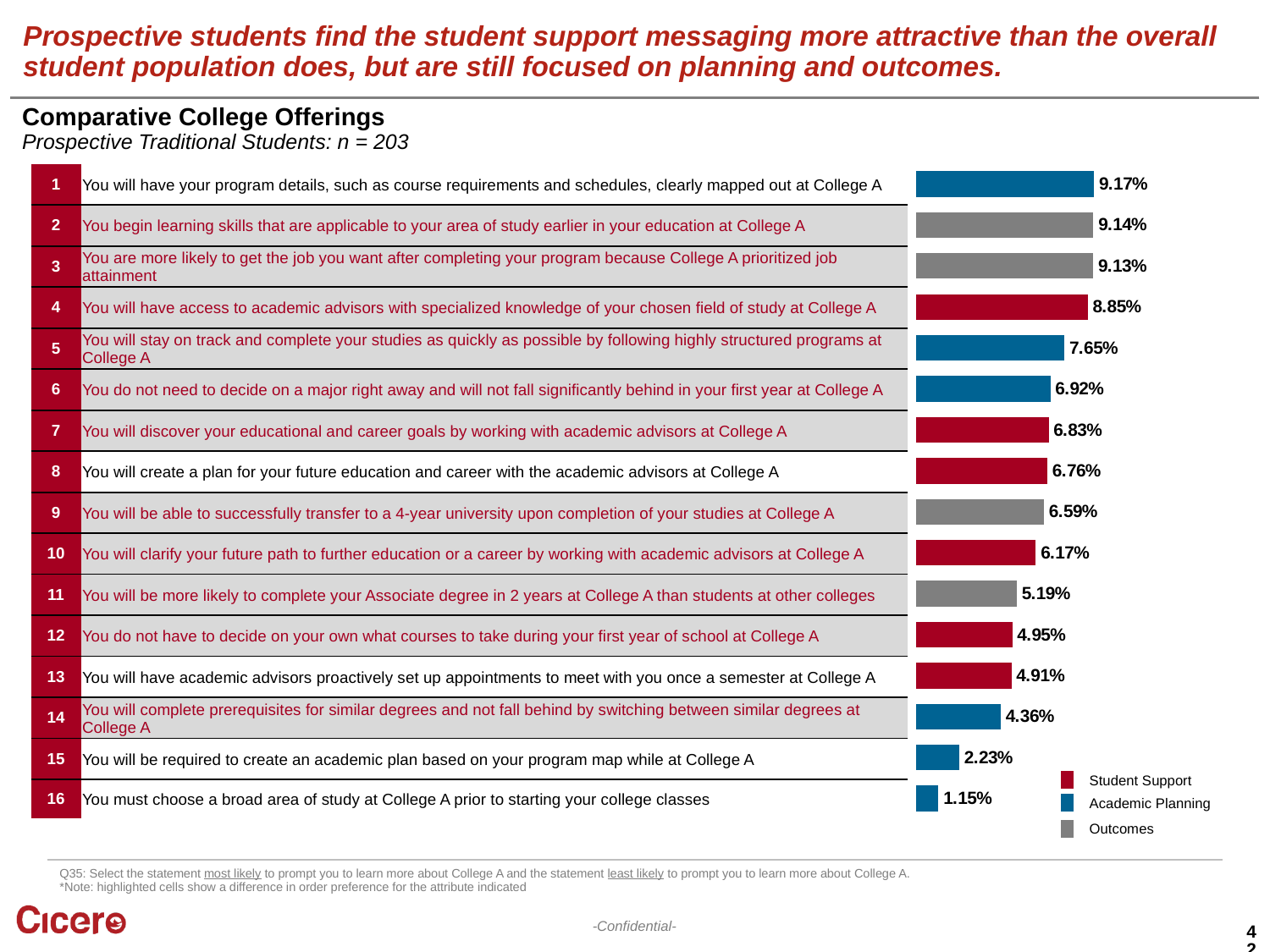
How many statements are plotted in the chart? 16 Which statement has the highest value in the chart? Statement 1 (9.17%) What is the value for statement 14, "You will complete prerequisites for similar degrees and not fall behind by switching between similar degrees at College A"? 4.36% What kind of chart is shown on the slide? Bar chart What is the difference between the value for statement 1 (9.17%) and the value for statement 16 (1.15%)? 8.02% How many series does the legend list? 3 What are the three series named in the legend? Student Support, Academic Planning, Outcomes Which statement has the lowest value in the chart? Statement 16 (1.15%) What is the value for statement 16, "You must choose a broad area of study at College A prior to starting your college classes"? 1.15% What is the value for statement 9, "You will be able to successfully transfer to a 4-year university upon completion of your studies at College A"? 6.59% Which has a larger value: statement 5 or statement 11? Statement 5 What is the value for statement 1, "You will have your program details, such as course requirements and schedules, clearly mapped out at College A"? 9.17%